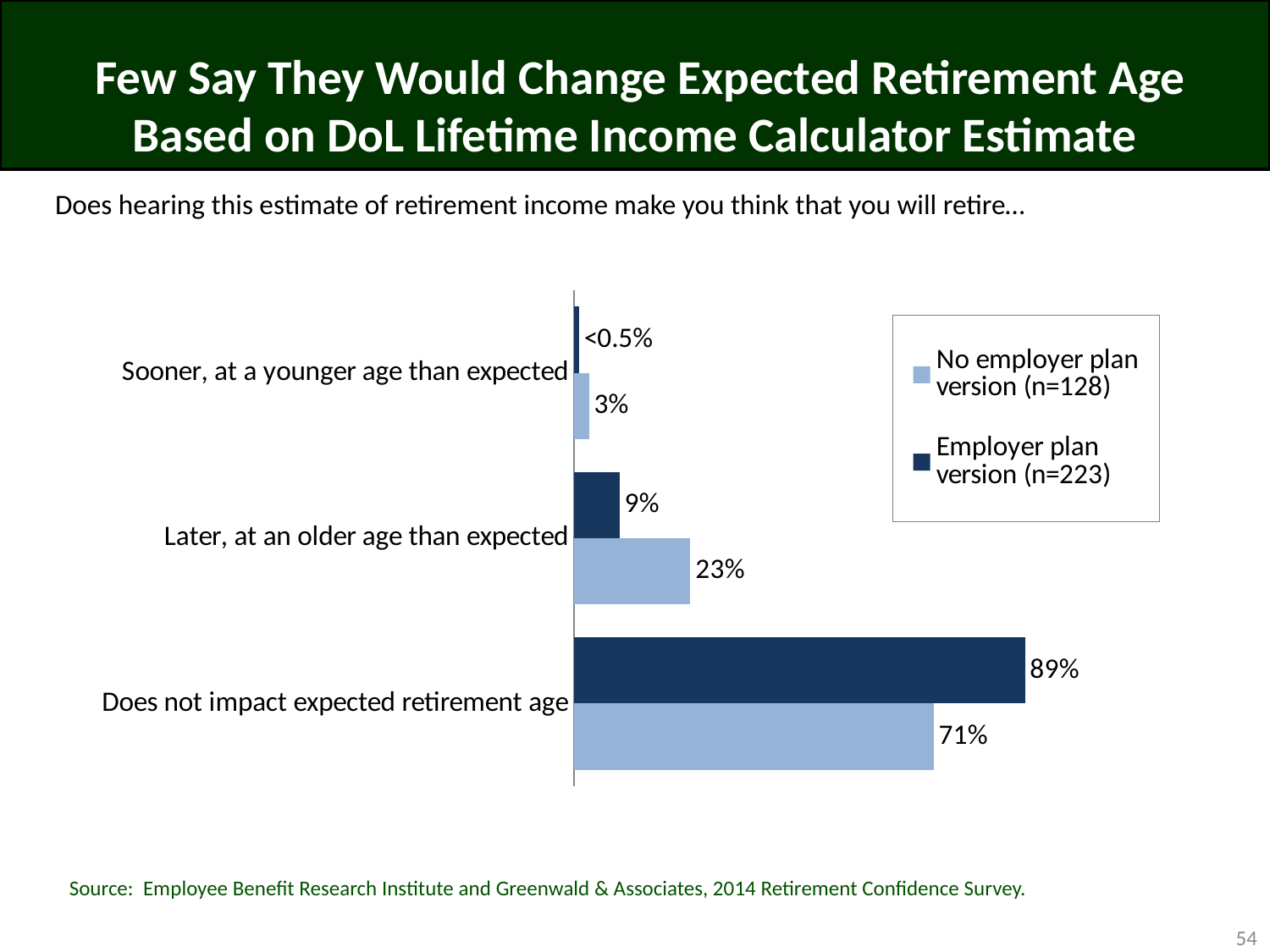
What kind of chart is shown on the slide? Bar chart How many series does the legend list? 2 Which response category has the lowest value for the Employer plan version? Sooner, at a younger age than expected What percentage of the Employer plan version respondents say the estimate does not impact their expected retirement age? 89% For 'Later, at an older age than expected', which version has the larger value? No employer plan version (n=128) What percentage of the No employer plan version respondents say they would retire sooner, at a younger age than expected? 3% How many response categories are shown in the chart? 3 Which response category has the highest value for the No employer plan version? Does not impact expected retirement age What value is shown for the Employer plan version for 'Sooner, at a younger age than expected'? <0.5% What is the difference between the No employer plan version and the Employer plan version for 'Later, at an older age than expected'? 14% What percentage of the No employer plan version respondents say they would retire later, at an older age than expected? 23% What is the difference between the Employer plan version and the No employer plan version for 'Does not impact expected retirement age'? 18%